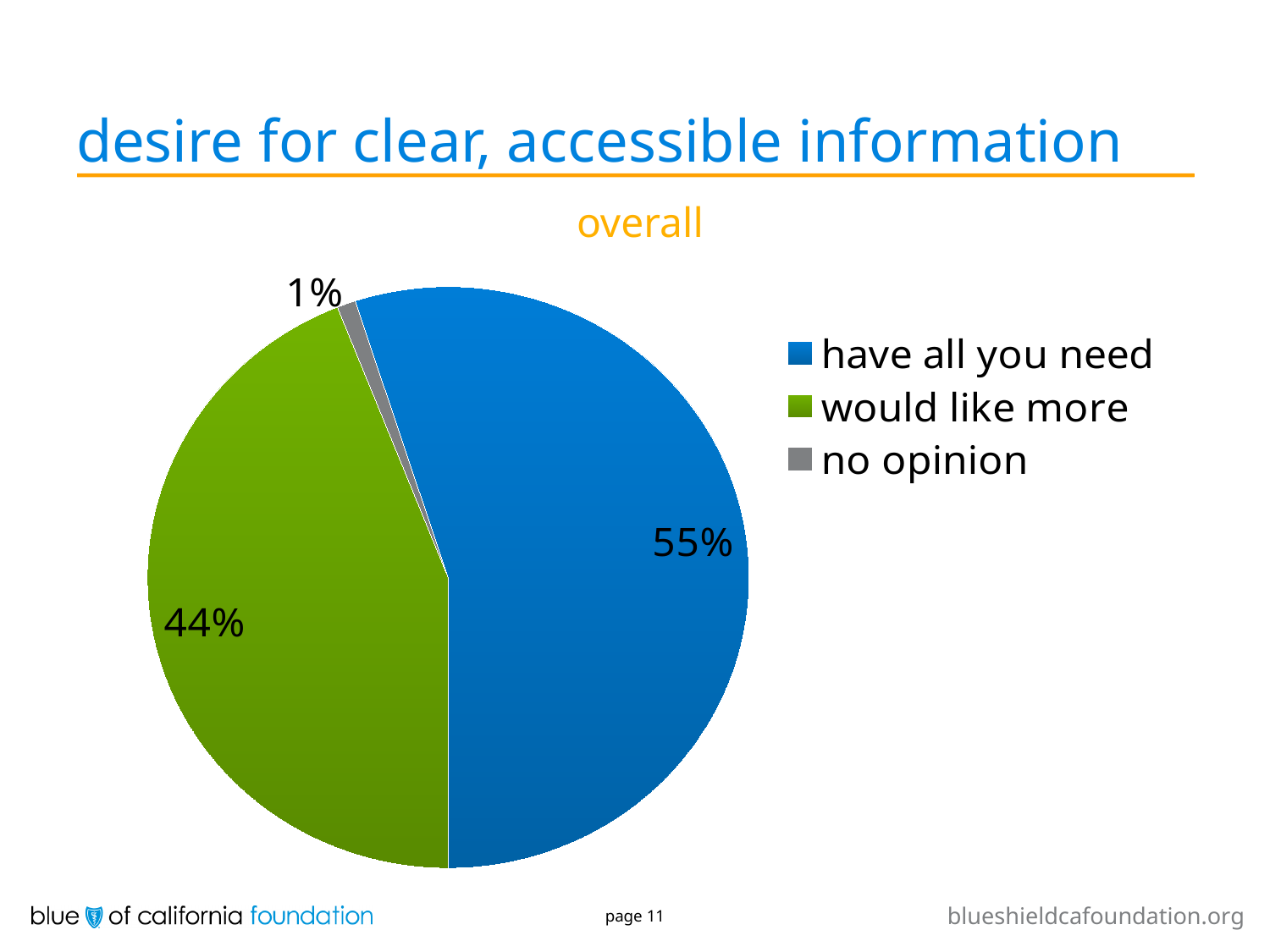
What is the title of the chart? overall What kind of chart is shown on the slide? pie chart Which category has the smallest share of the pie? no opinion How many categories does the legend list? 3 What percentage of respondents said they would like more? 44% What share of the pie does the 'have all you need' slice represent? 55% Which is larger, the share for 'would like more' or the share for 'no opinion'? would like more Which category has the largest share of the pie? have all you need What percentage of respondents said they have all they need? 55% What colour is the 'would like more' slice? green What percentage of respondents had no opinion? 1% What is the difference in percentage points between 'have all you need' and 'would like more'? 11